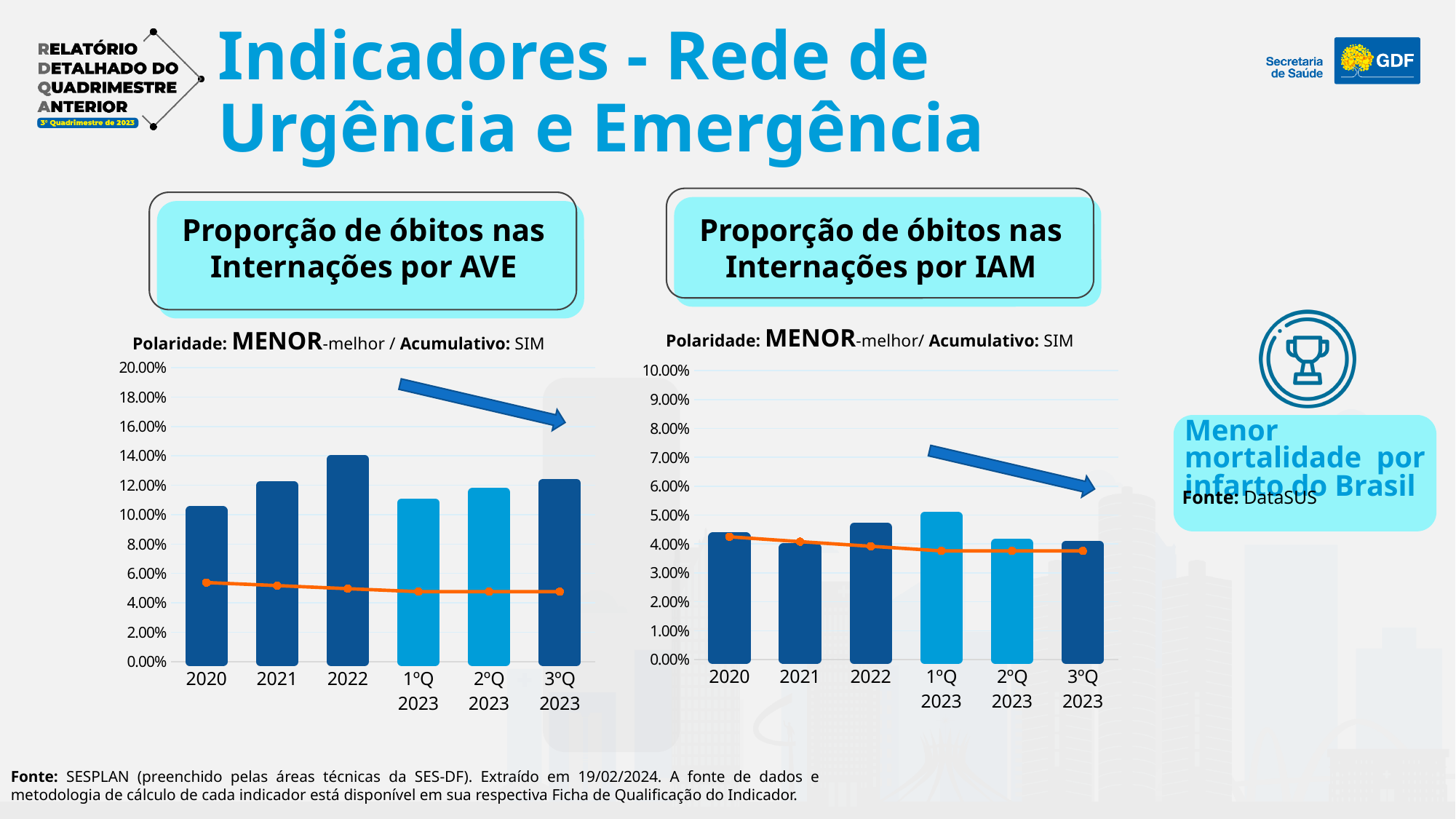
In the 'Proporção de óbitos nas Internações por AVE' chart, which category has the tallest bar? 2022 How many categories are shown on the x axis of the 'Proporção de óbitos nas Internações por AVE' chart? 6 In the 'Proporção de óbitos nas Internações por AVE' chart, does the orange line rise or fall from 2020 to 3ºQ 2023? Fall In the 'Proporção de óbitos nas Internações por IAM' chart, is the bar for 2022 greater or less than 4.00%? greater In the 'Proporção de óbitos nas Internações por IAM' chart, which bar is taller, 2021 or 2022? 2022 In the 'Proporção de óbitos nas Internações por AVE' chart, is the bar for 2020 greater or less than 12.00%? less What is the top value shown on the y axis of the 'Proporção de óbitos nas Internações por IAM' chart? 10.00% In the 'Proporção de óbitos nas Internações por IAM' chart, is the bar for 2021 greater or less than 5.00%? less In the 'Proporção de óbitos nas Internações por AVE' chart, which bar is taller, 2021 or 2022? 2022 What kind of chart is the 'Proporção de óbitos nas Internações por IAM' chart? Bar chart with a line In the 'Proporção de óbitos nas Internações por IAM' chart, which category has the tallest bar? 1ºQ 2023